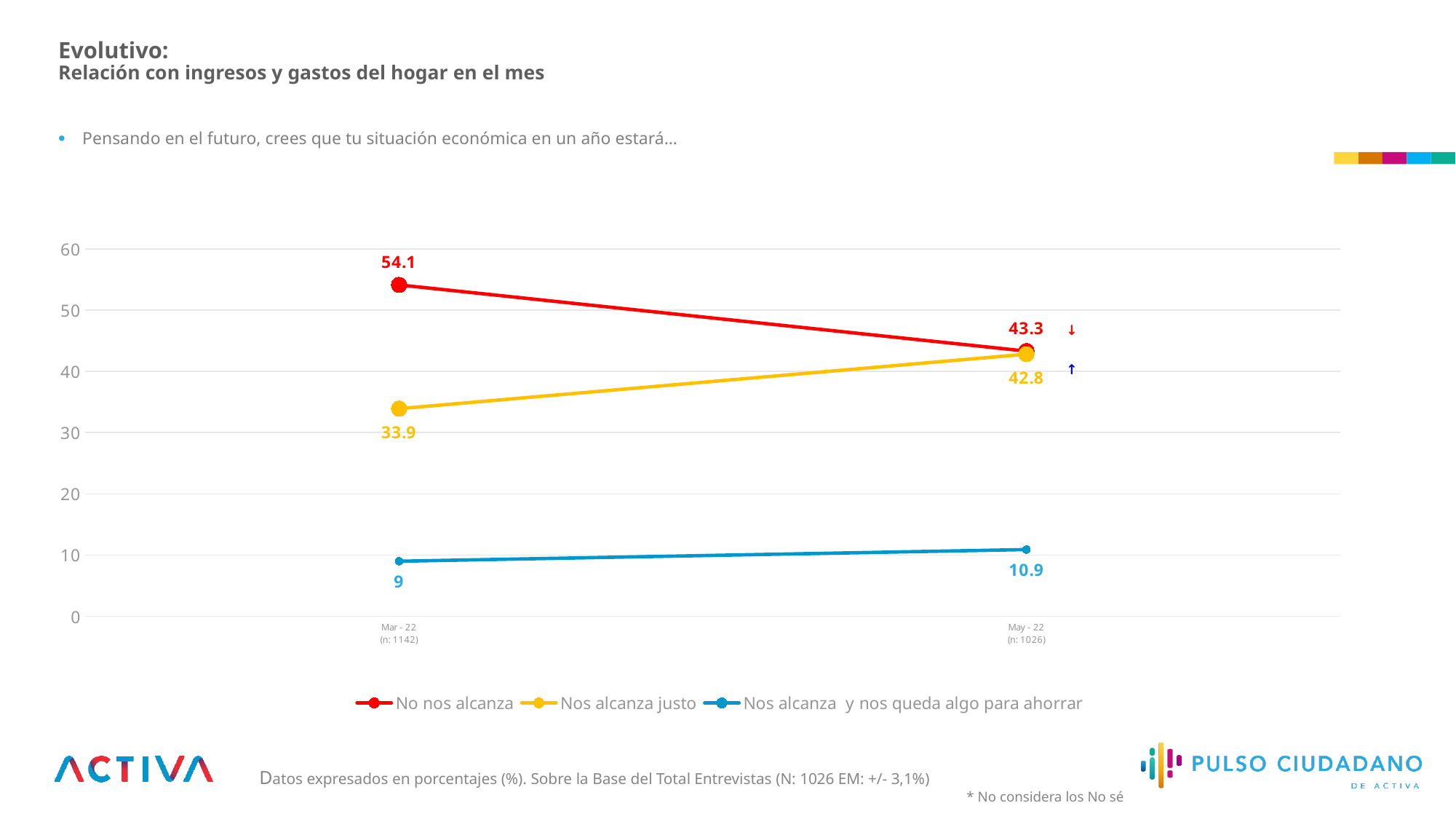
How many series does the legend list? 3 Which series has the highest value in Mar - 22? No nos alcanza What is the value for "Nos alcanza justo" in May - 22? 42.8 What is the value for "Nos alcanza y nos queda algo para ahorrar" in Mar - 22? 9 Which series has the lowest value in May - 22? Nos alcanza y nos queda algo para ahorrar Does the value for "Nos alcanza justo" rise or fall from Mar - 22 to May - 22? Rise What kind of chart is shown on the slide? Line chart What is the difference between "Nos alcanza justo" in May - 22 and Mar - 22? 8.9 By how much did "No nos alcanza" change from Mar - 22 to May - 22? 10.8 Which is larger in Mar - 22: "No nos alcanza" or "Nos alcanza justo"? No nos alcanza What is the value for "No nos alcanza" in Mar - 22? 54.1 What is the value for "No nos alcanza" in May - 22? 43.3